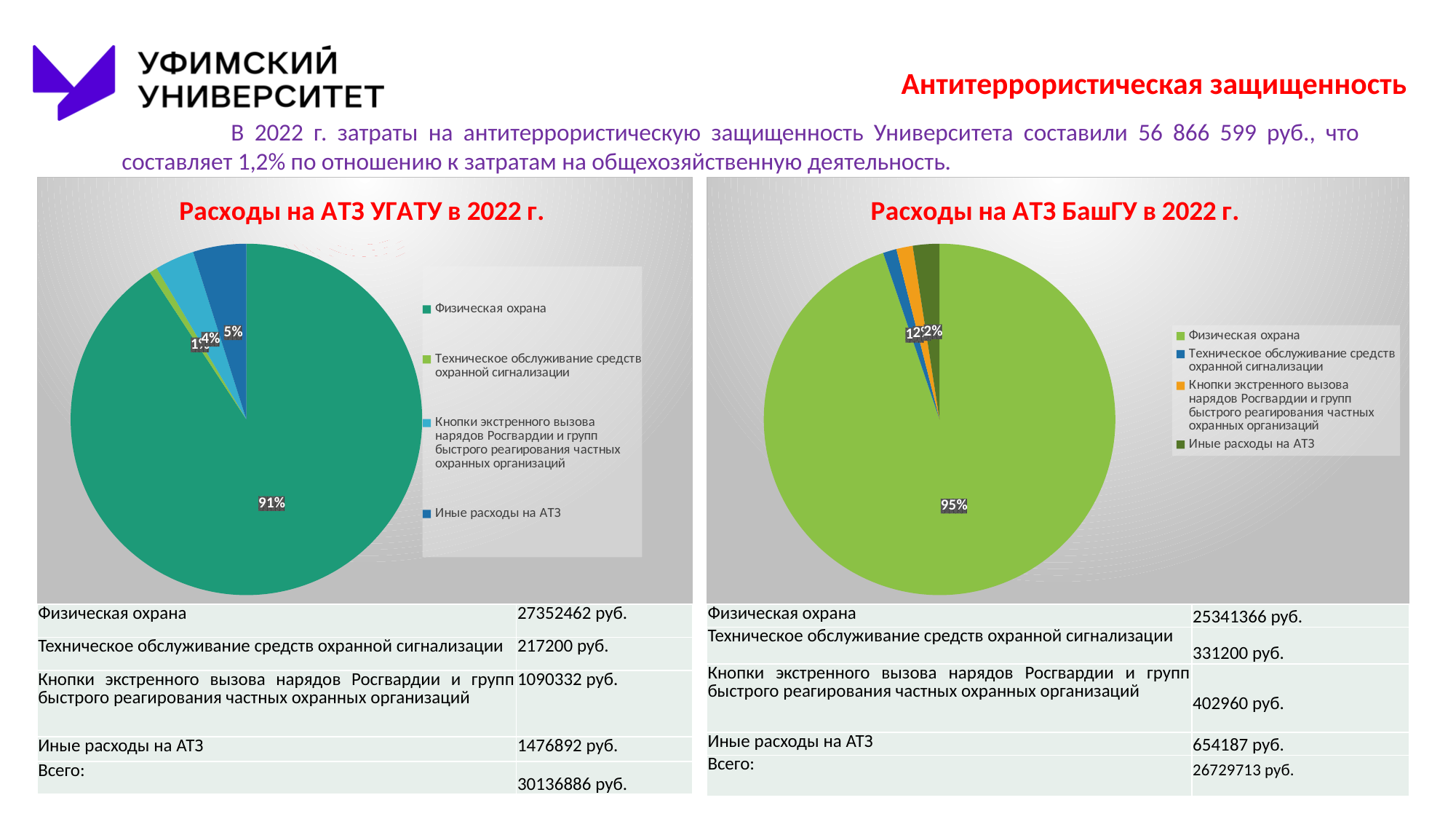
In the chart "Расходы на АТЗ УГАТУ в 2022 г.", which category has the largest slice? Физическая охрана In the chart "Расходы на АТЗ УГАТУ в 2022 г.", which is larger: the slice for "Иные расходы на АТЗ" or the slice for "Кнопки экстренного вызова нарядов Росгвардии и групп быстрого реагирования частных охранных организаций"? Иные расходы на АТЗ In the chart "Расходы на АТЗ БашГУ в 2022 г.", which category has the largest slice? Физическая охрана Which chart shows a larger share for "Физическая охрана": "Расходы на АТЗ УГАТУ в 2022 г." or "Расходы на АТЗ БашГУ в 2022 г."? Расходы на АТЗ БашГУ в 2022 г. How many categories are shown in the chart "Расходы на АТЗ УГАТУ в 2022 г."? 4 In the chart "Расходы на АТЗ БашГУ в 2022 г.", what share does "Физическая охрана" have? 95% What is the difference in percentage points between the "Физическая охрана" share in the chart "Расходы на АТЗ БашГУ в 2022 г." and in the chart "Расходы на АТЗ УГАТУ в 2022 г."? 4 percentage points What colour is the "Физическая охрана" slice in the chart "Расходы на АТЗ БашГУ в 2022 г."? Green In the chart "Расходы на АТЗ УГАТУ в 2022 г.", what share does "Иные расходы на АТЗ" have? 5% In the chart "Расходы на АТЗ УГАТУ в 2022 г.", what share does "Физическая охрана" have? 91% What kind of chart is "Расходы на АТЗ УГАТУ в 2022 г."? Pie chart How many categories does the legend of the chart "Расходы на АТЗ БашГУ в 2022 г." list? 4